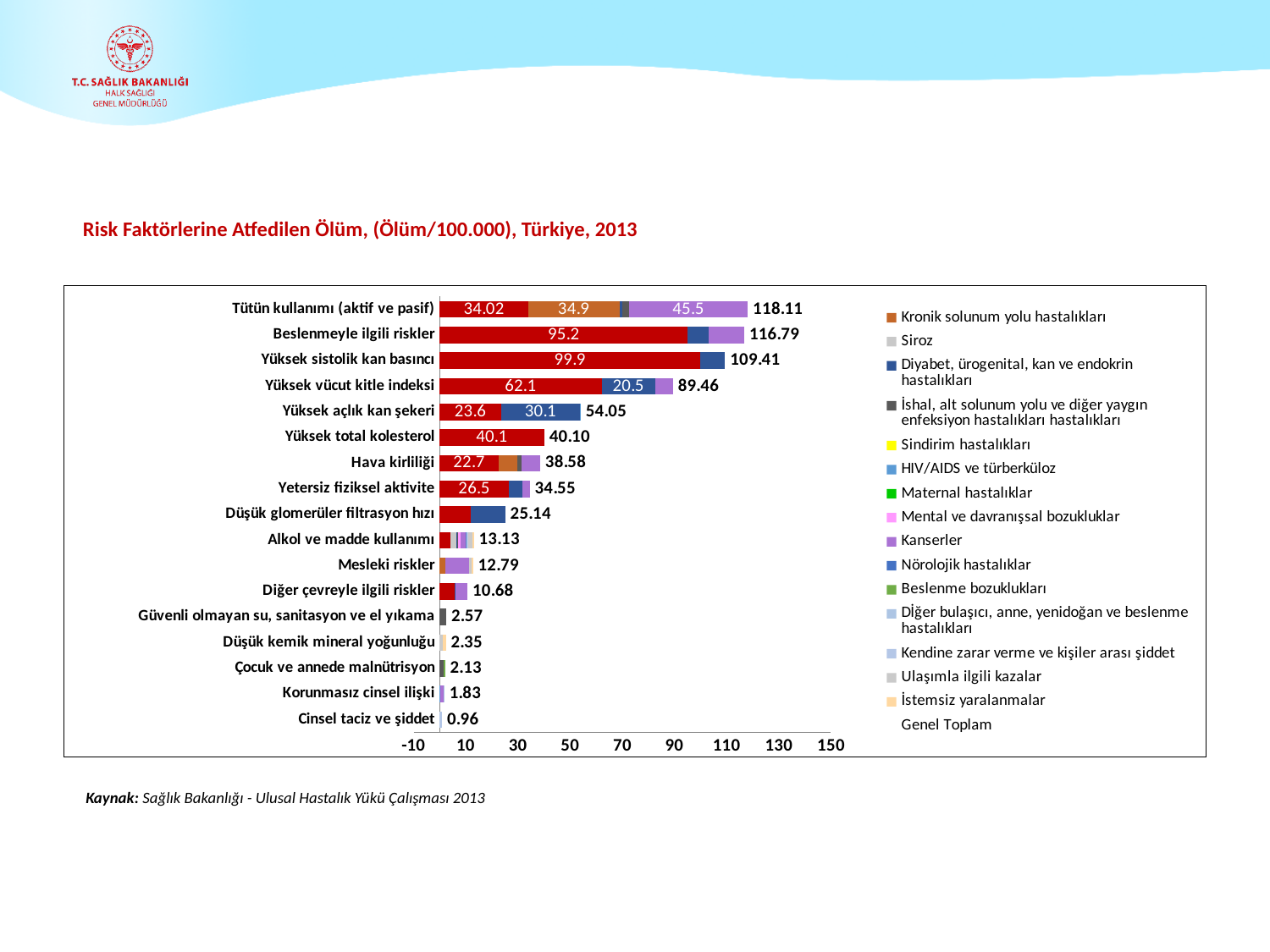
What is the value of the Kanserler segment in the Tütün kullanımı (aktif ve pasif) bar? 45.5 How many risk factor categories are shown in the chart? 17 What is the difference between the totals for Tütün kullanımı (aktif ve pasif) and Beslenmeyle ilgili riskler? 1.32 Which has a larger total, Hava kirliliği or Yetersiz fiziksel aktivite? Hava kirliliği What kind of chart is shown on the slide? Stacked bar chart What is the total value shown for Tütün kullanımı (aktif ve pasif)? 118.11 What is the difference between the totals for Yüksek sistolik kan basıncı and Yüksek vücut kitle indeksi? 19.95 What is the title of the chart? Risk Faktörlerine Atfedilen Ölüm, (Ölüm/100.000), Türkiye, 2013 Which risk factor has the highest total value in the chart? Tütün kullanımı (aktif ve pasif) What is the total value shown for Cinsel taciz ve şiddet? 0.96 Which risk factor has the lowest total value in the chart? Cinsel taciz ve şiddet Is the total value for Düşük glomerüler filtrasyon hızı greater or less than 30? less